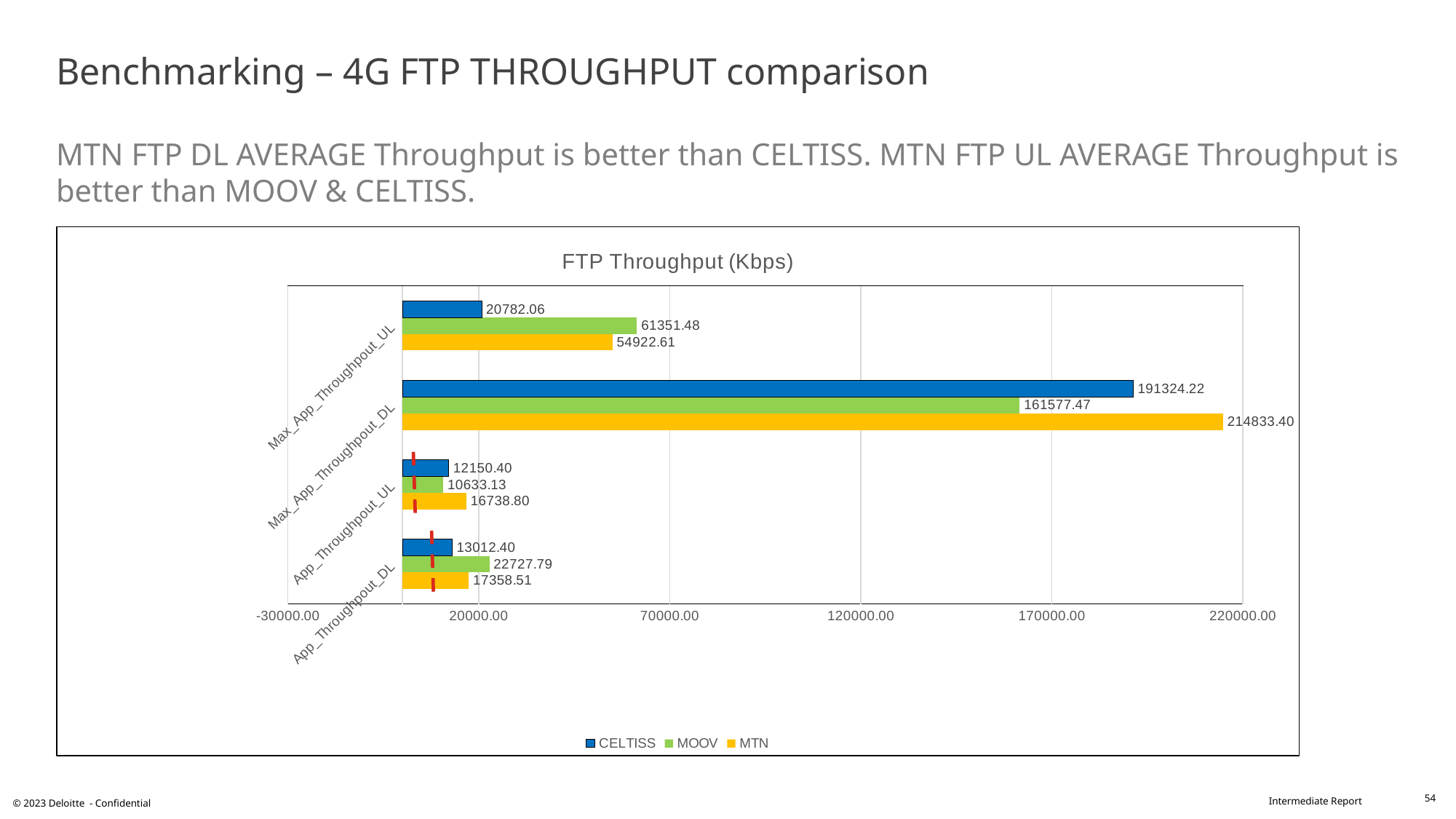
How many categories are shown on the chart? 4 What type of chart is shown on the slide? Bar chart What is the MOOV value for Max_App_Throughpout_UL? 61351.48 Which operator has the lowest value for App_Throughpout_UL? MOOV What is the CELTISS value for App_Throughpout_UL? 12150.40 Which operator has the highest value for Max_App_Throughpout_DL? MTN For App_Throughpout_DL, which is larger: the MOOV value or the MTN value? MOOV Which series is shown in yellow? MTN What is the title of the chart? FTP Throughput (Kbps) What is the MTN value for Max_App_Throughpout_DL? 214833.40 How many series does the legend list? 3 What is the difference between the MTN and CELTISS values for Max_App_Throughpout_DL? 23509.18